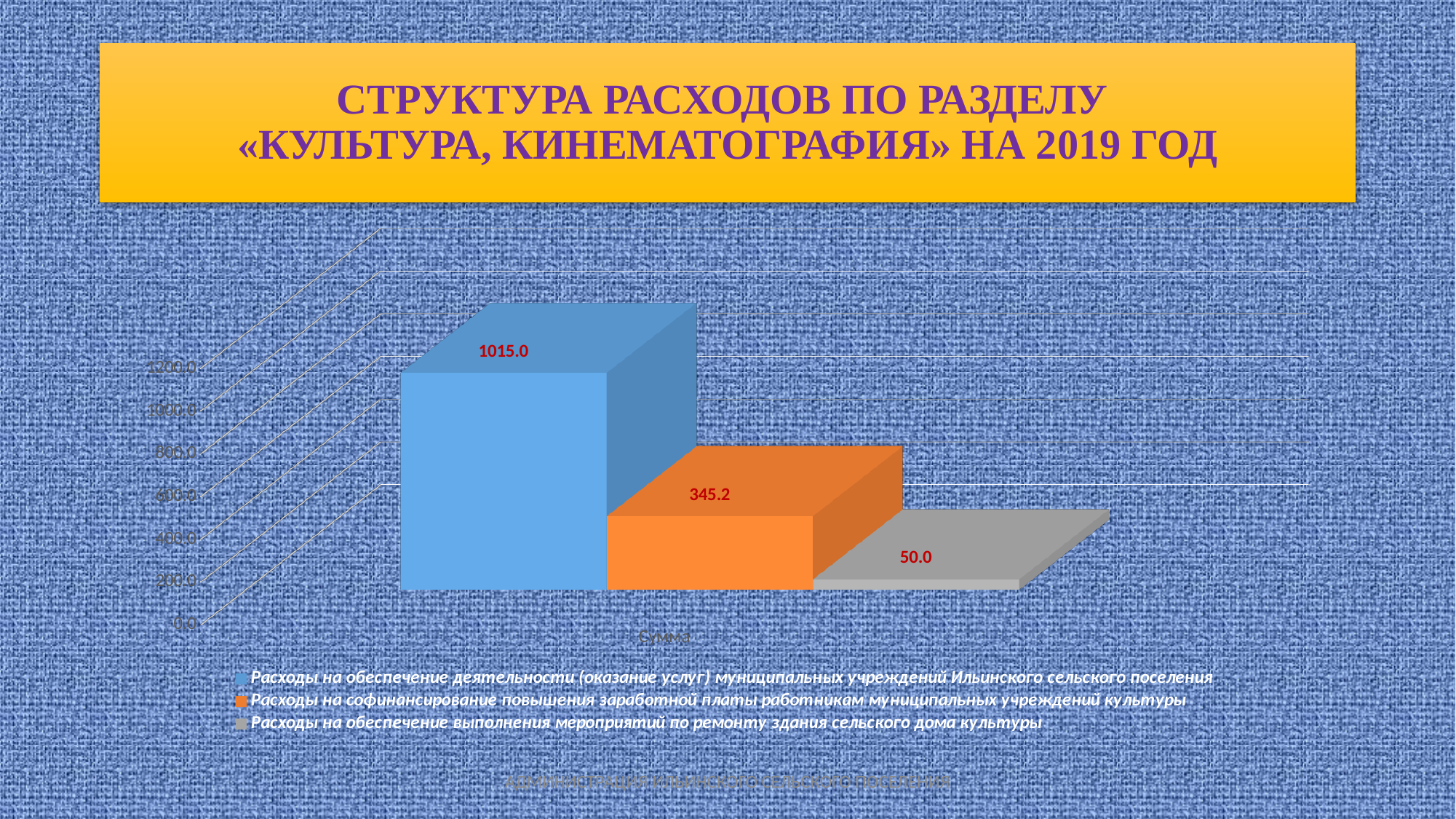
What kind of chart is shown on the slide? bar chart What is the difference between the value for 'Расходы на софинансирование повышения заработной платы работникам муниципальных учреждений культуры' and the value for 'Расходы на обеспечение выполнения мероприятий по ремонту здания сельского дома культуры'? 295.2 Which series has the highest value? Расходы на обеспечение деятельности (оказание услуг) муниципальных учреждений Ильинского сельского поселения Which is larger: the value for 'Расходы на софинансирование повышения заработной платы работникам муниципальных учреждений культуры' or the value for 'Расходы на обеспечение выполнения мероприятий по ремонту здания сельского дома культуры'? Расходы на софинансирование повышения заработной платы работникам муниципальных учреждений культуры What is the title of the slide? СТРУКТУРА РАСХОДОВ ПО РАЗДЕЛУ «КУЛЬТУРА, КИНЕМАТОГРАФИЯ» НА 2019 ГОД What is the value for 'Расходы на софинансирование повышения заработной платы работникам муниципальных учреждений культуры'? 345.2 How many series does the legend list? 3 Which series has the lowest value? Расходы на обеспечение выполнения мероприятий по ремонту здания сельского дома культуры What is the value for 'Расходы на обеспечение выполнения мероприятий по ремонту здания сельского дома культуры'? 50.0 What is the difference between the value for 'Расходы на обеспечение деятельности (оказание услуг) муниципальных учреждений Ильинского сельского поселения' and the value for 'Расходы на софинансирование повышения заработной платы работникам муниципальных учреждений культуры'? 669.8 Is the value for 'Расходы на обеспечение деятельности (оказание услуг) муниципальных учреждений Ильинского сельского поселения' greater or less than 1000.0? greater What is the value for 'Расходы на обеспечение деятельности (оказание услуг) муниципальных учреждений Ильинского сельского поселения'? 1015.0